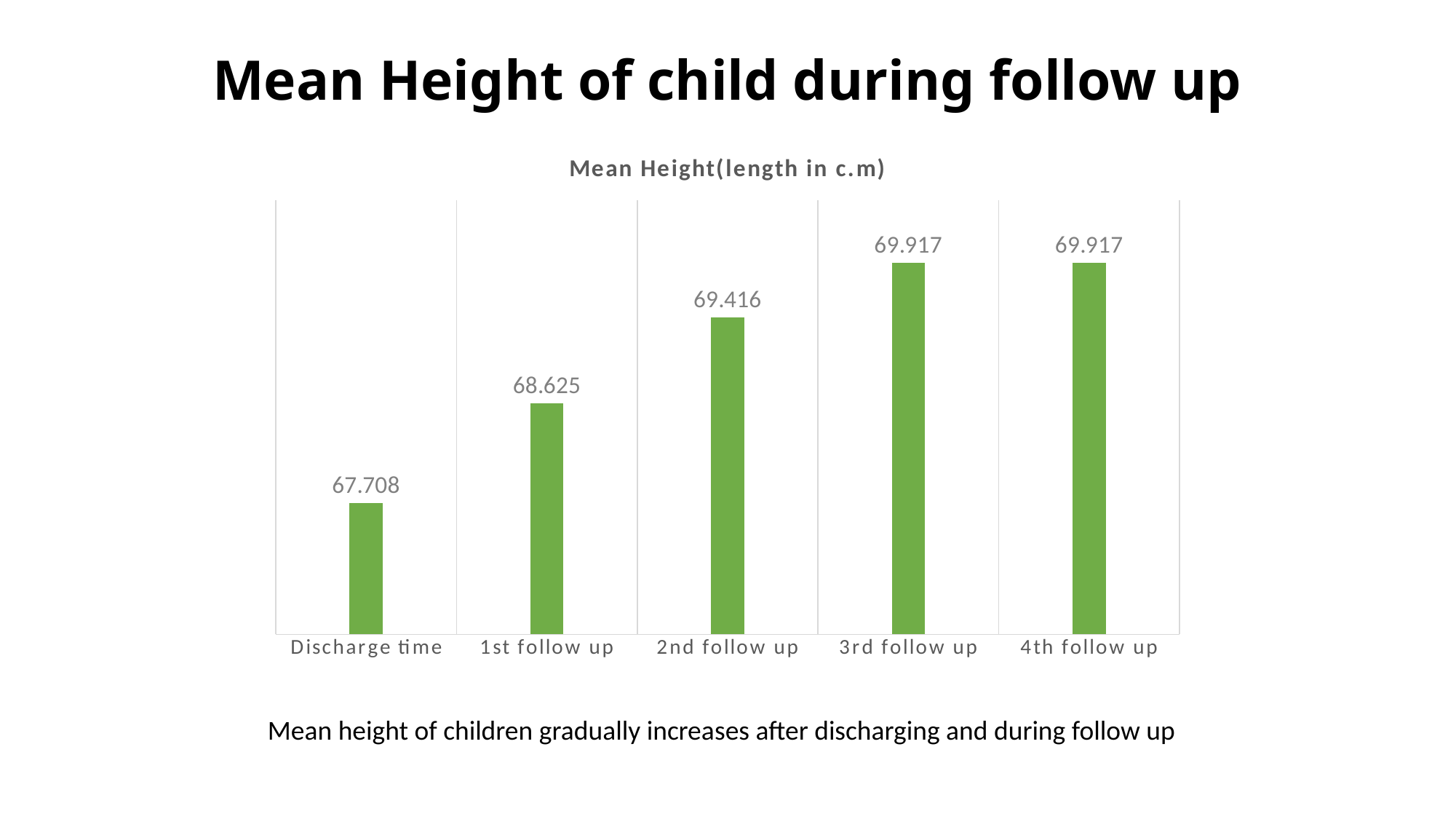
What is the mean height at the 4th follow up? 69.917 How many time points are shown on the chart? 5 What is the difference in mean height between the 1st follow up and discharge time? 0.917 Which has a larger mean height, the 2nd follow up or the 1st follow up? 2nd follow up What is the difference in mean height between the 4th follow up and discharge time? 2.209 Do the mean height values rise or fall from discharge time to the 4th follow up? Rise What kind of chart is shown on the slide? Bar chart What is the mean height at the 1st follow up? 68.625 What is the mean height at discharge time? 67.708 What is the mean height at the 2nd follow up? 69.416 Which time point has the lowest mean height? Discharge time What is the title shown above the chart's plot area? Mean Height(length in c.m)